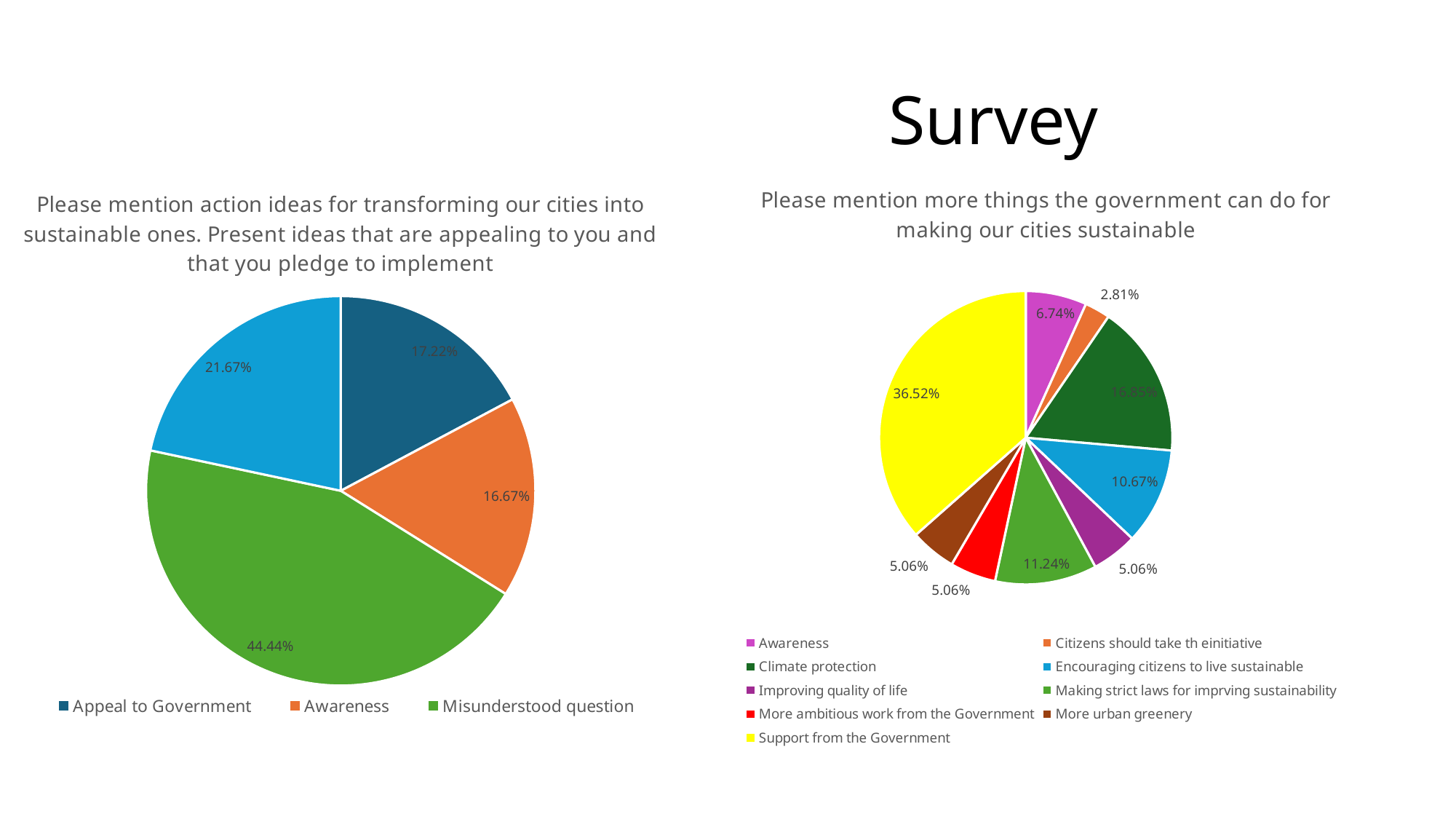
In the right pie chart (things the government can do), which category has the smallest slice? Citizens should take th einitiative In the left pie chart (action ideas for transforming our cities), how many percentage points larger is Misunderstood question than Awareness? 27.77 percentage points In the right pie chart (things the government can do), what percentage is shown for Support from the Government? 36.52% In the left pie chart (action ideas for transforming our cities), which legend category has the largest slice? Misunderstood question In the right pie chart (things the government can do), which is larger: Climate protection or Encouraging citizens to live sustainable? Climate protection In the left pie chart (action ideas for transforming our cities), what percentage is shown for Appeal to Government? 17.22% How many categories does the legend of the right pie chart (things the government can do) list? 9 In the right pie chart (things the government can do), what percentage is shown for Making strict laws for improving sustainability? 11.24% What type of chart is the left chart (action ideas for transforming our cities)? Pie chart In the left pie chart (action ideas for transforming our cities), what percentage is shown for Awareness? 16.67% In the left pie chart (action ideas for transforming our cities), what percentage is shown for Misunderstood question? 44.44% In the right pie chart (things the government can do), what percentage is shown for Climate protection? 16.85%